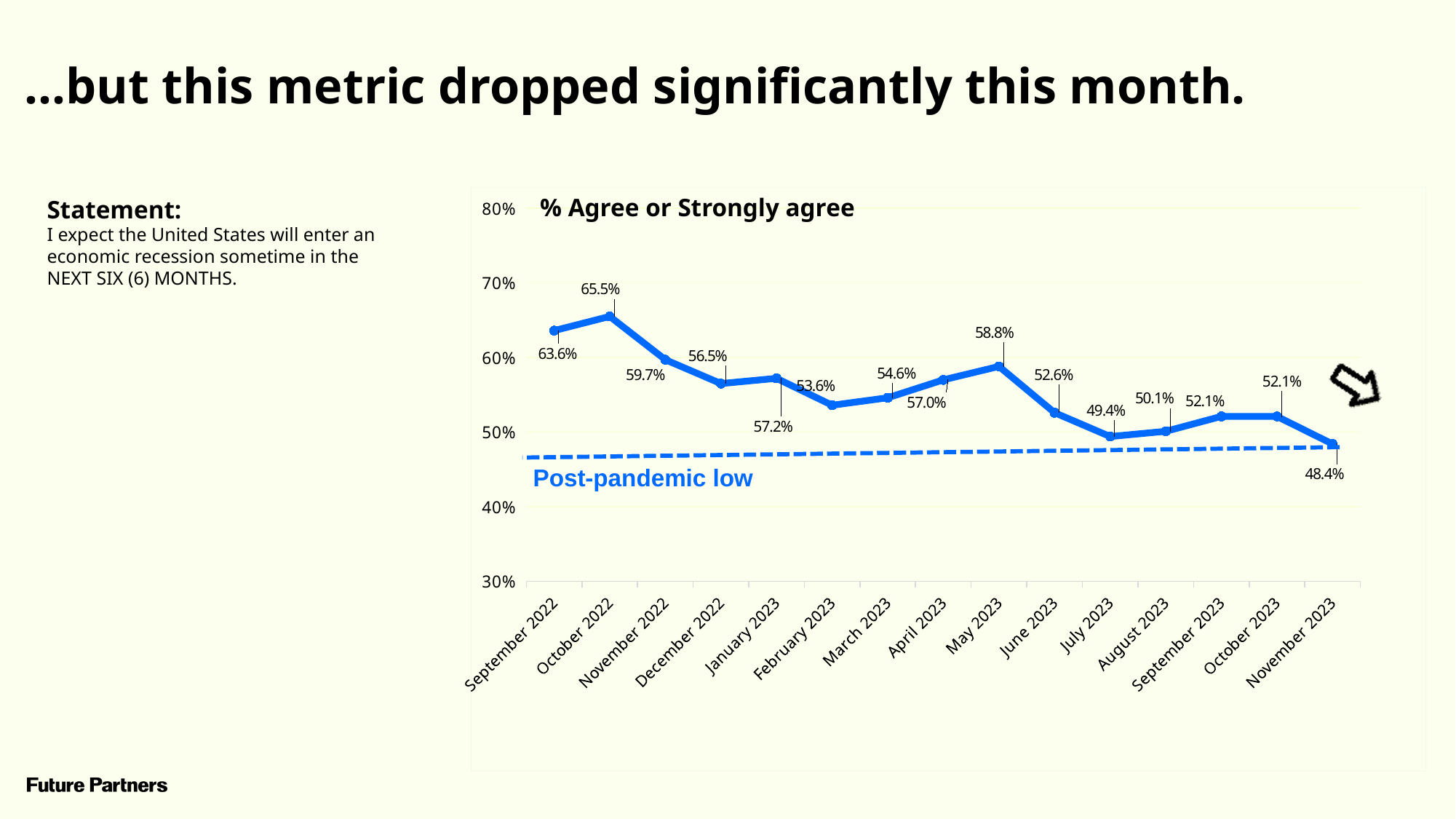
Do the values generally rise or fall from September 2022 to November 2023? Fall How many months are plotted on the chart? 15 What is the difference between the October 2023 value and the November 2023 value? 3.7 percentage points Which month has the lowest value? November 2023 What is the value for May 2023? 58.8% What does the dashed horizontal line on the chart represent? Post-pandemic low Which month has the highest value? October 2022 Which is larger, the value for April 2023 or the value for June 2023? April 2023 What is the value for November 2023? 48.4% What is the value for July 2023? 49.4% What is the value for October 2022? 65.5% What type of chart is shown on the slide? Line chart